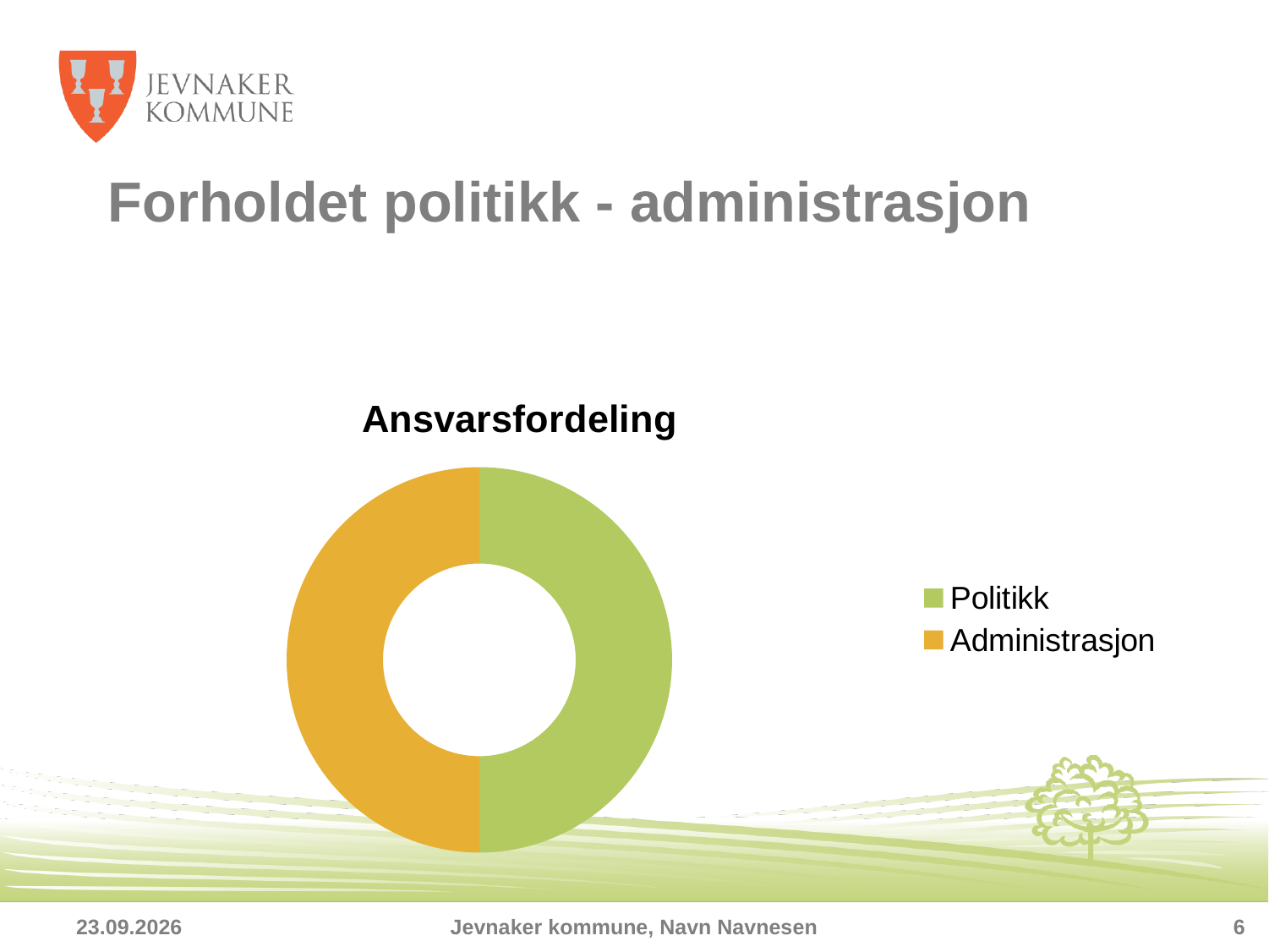
Which category is shown in orange? Administrasjon What kind of chart is shown on the slide? doughnut chart What is the title of the chart? Ansvarsfordeling How many entries does the legend list? 2 Which colour represents Politikk in the chart? green How many categories does the chart show? 2